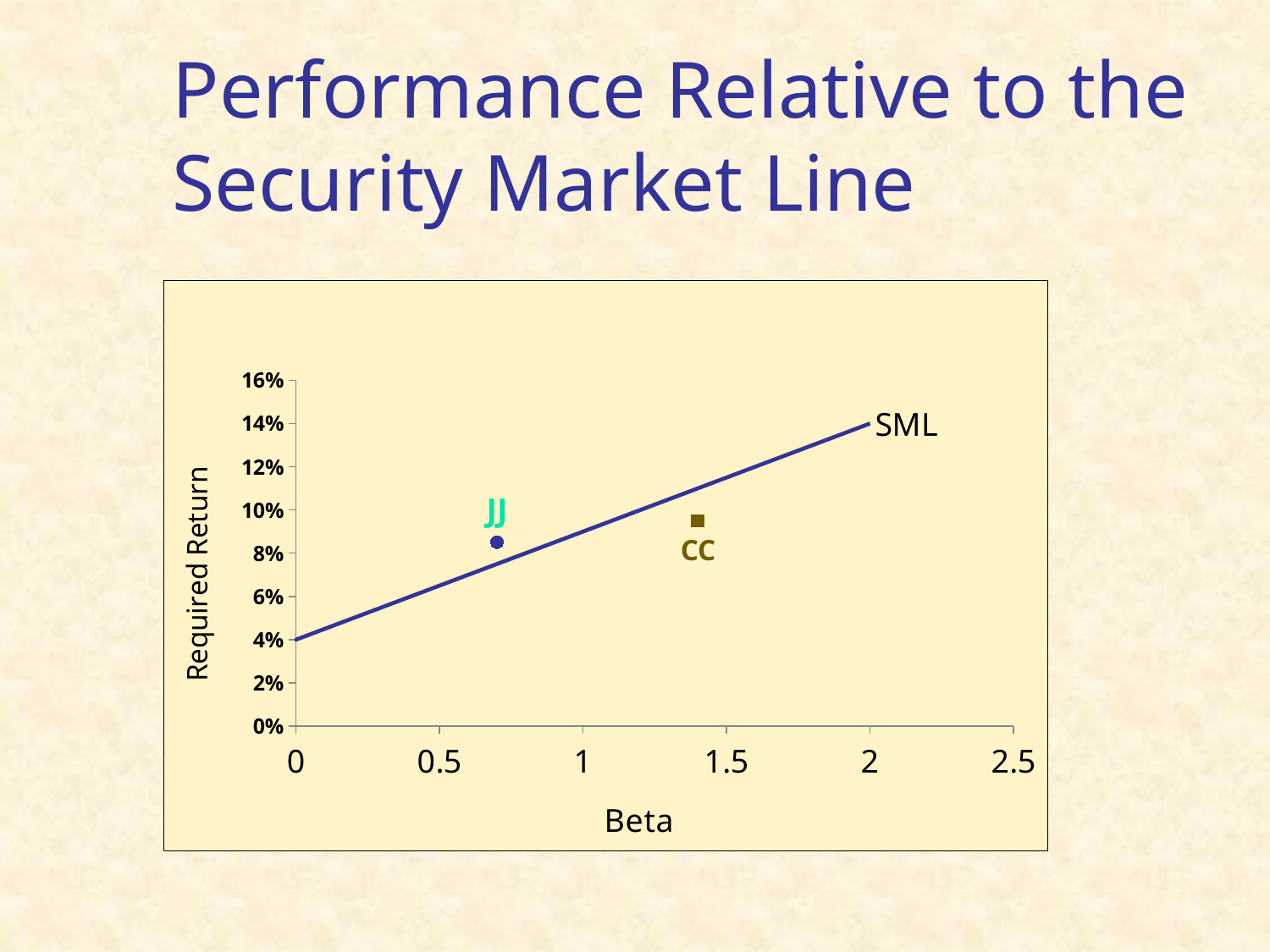
What is the required return on the SML line at a beta of 0? 4% Is the required return for CC greater or less than 8%? greater What label is given to the x axis of the chart? Beta Which security has the higher beta, JJ or CC? CC Is the beta of JJ greater or less than 1? less Does the SML line rise or fall as beta increases? rise What is the required return on the SML line at a beta of 2? 14% What is the title of the slide containing the chart? Performance Relative to the Security Market Line Is the required return for JJ greater or less than 10%? less Which security is plotted above the SML line, JJ or CC? JJ How many individual securities (labelled points) are plotted on the chart? 2